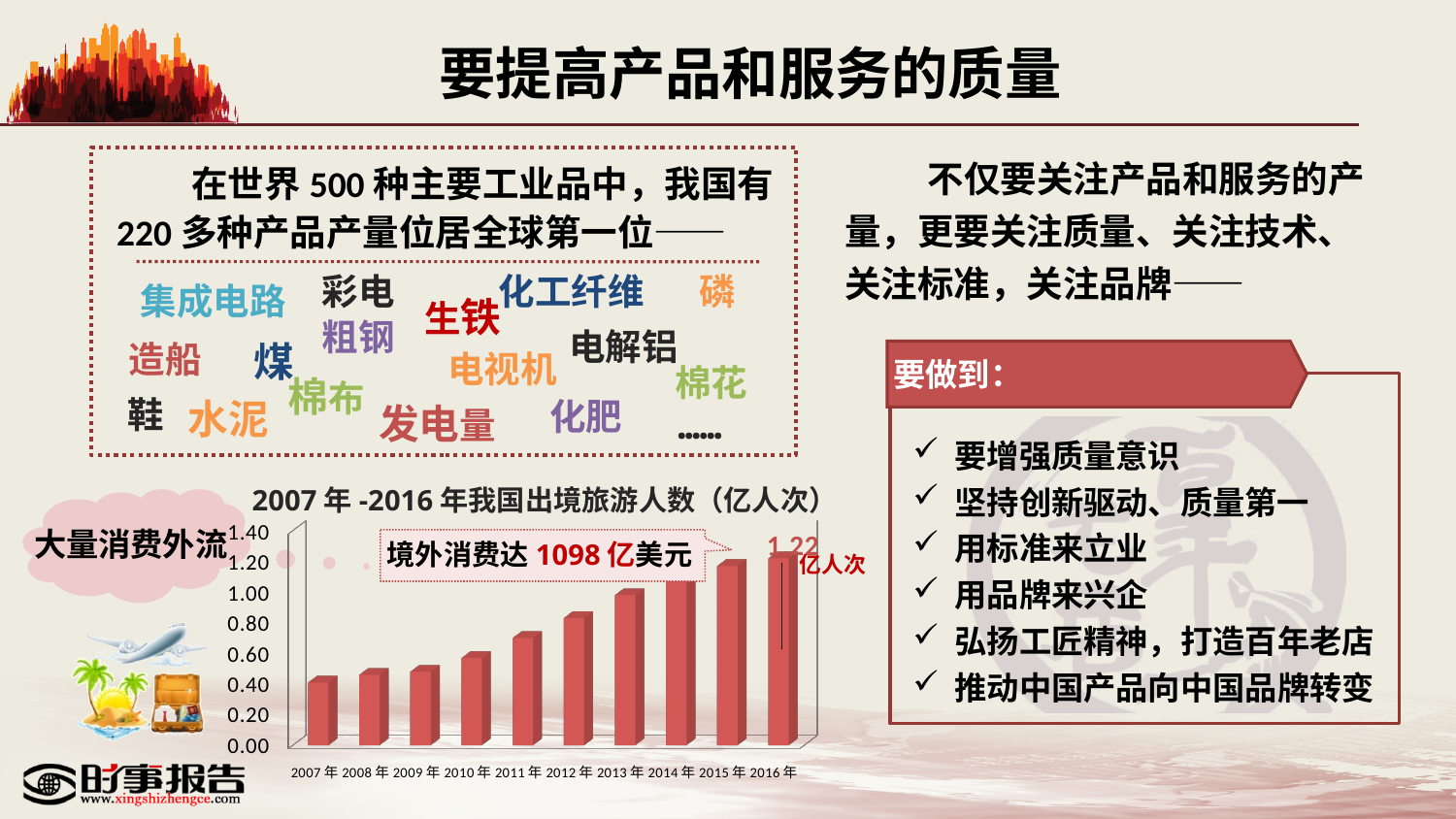
Which year has the lowest value in the chart? 2007年 How many years are shown on the x axis of the chart? 10 Which is larger, the value for 2012年 or the value for 2015年? 2015年 Is the value for 2015年 greater or less than 1.00? greater What is the title of the chart? 2007年-2016年我国出境旅游人数（亿人次） Is the value for 2011年 greater or less than 0.60? greater Which year has the highest value in the chart? 2016年 Is the value for 2009年 greater or less than 0.60? less Do the values rise or fall from 2007年 to 2016年? rise What is the value for 2016年 in the chart? 1.22 What kind of chart is shown on the slide? bar chart